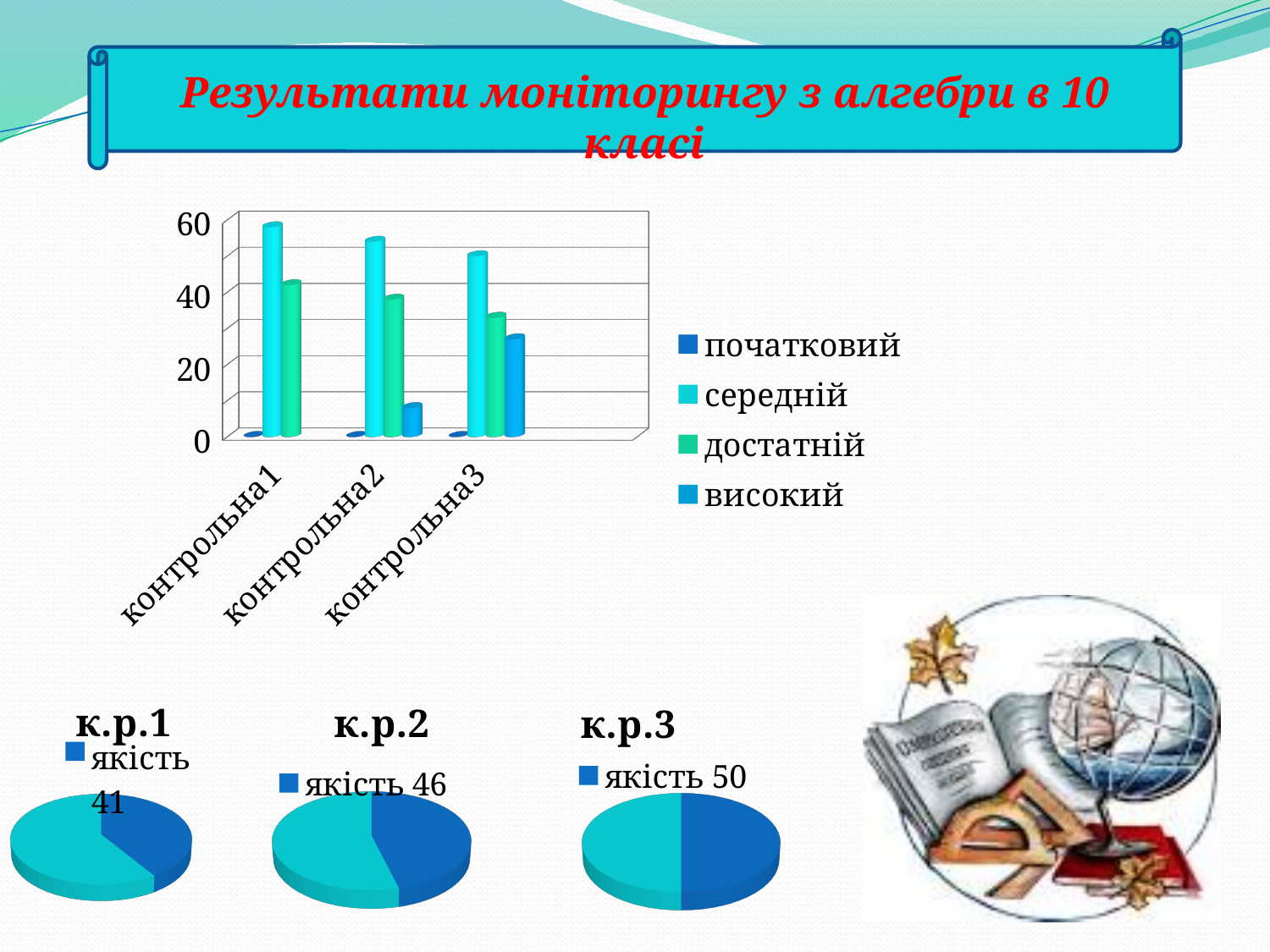
How many categories are shown on the x axis of the top bar chart? 3 In the top bar chart, is the value of високий for контрольна2 greater or less than 20? less How many series does the legend of the top bar chart list? 4 In the top bar chart, does the високий series rise or fall from контрольна1 to контрольна3? rises In the pie chart titled к.р.1, what value of якість is shown in the legend? 41 In the pie chart titled к.р.3, what value of якість is shown in the legend? 50 In the top bar chart, is the value of достатній for контрольна3 greater or less than 40? less In the top bar chart, is the value of середній for контрольна1 greater or less than 40? greater In the top bar chart, does the середній series rise or fall from контрольна1 to контрольна3? falls In the top bar chart, for контрольна2, which is larger: середній or достатній? середній In the top bar chart, which category has the highest value for високий? контрольна3 What kind of chart is the large chart at the top of the slide? bar chart